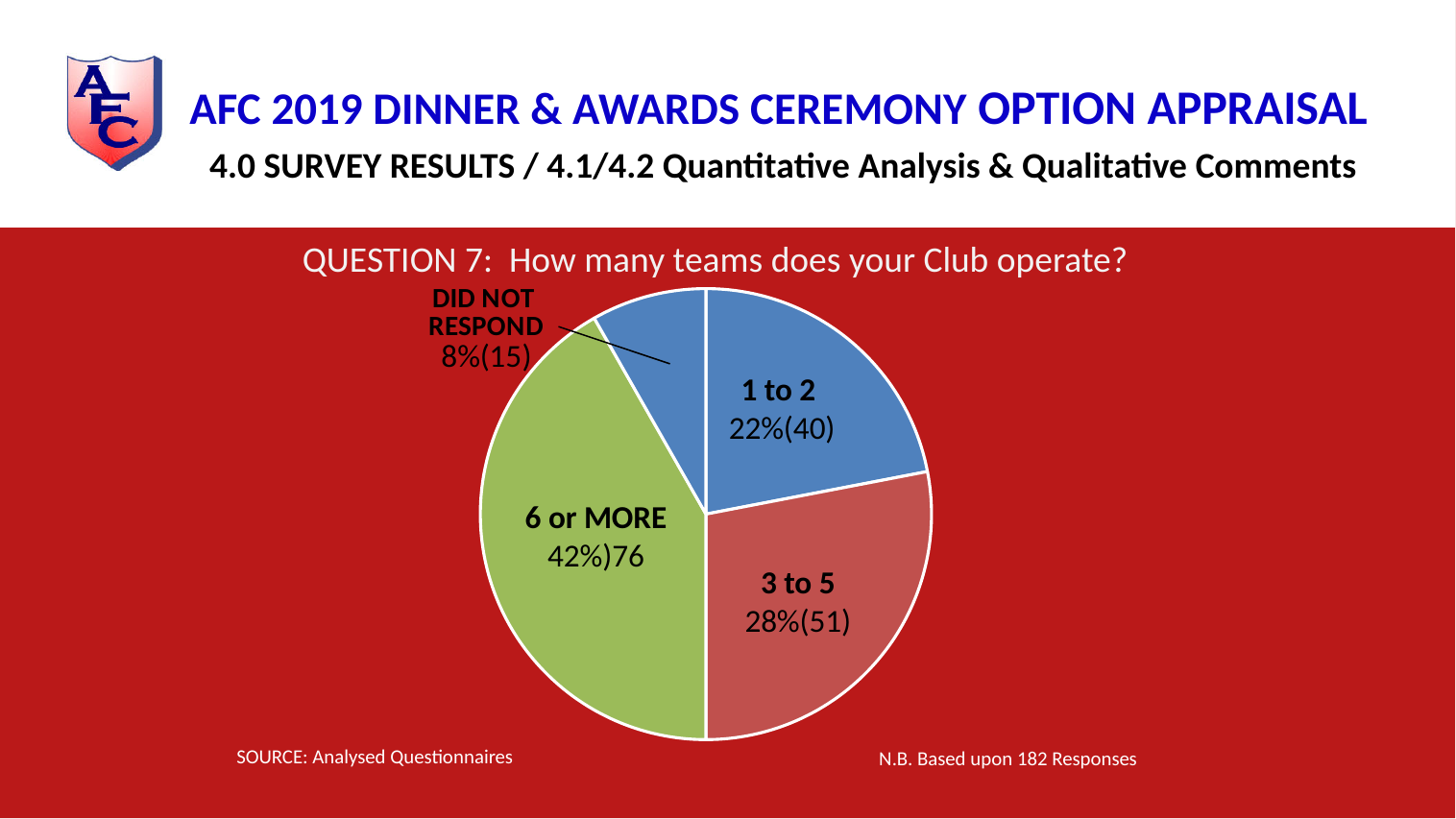
Which category has the smallest share of the pie? DID NOT RESPOND What percentage of respondents did not respond to Question 7? 8% What percentage of clubs operate 3 to 5 teams? 28% Which category has the largest share of the pie? 6 or MORE How many responses are in the '1 to 2' category? 40 What percentage of clubs operate 1 to 2 teams? 22% How many slices does the pie chart have? 4 What is the difference in percentage points between the '6 or MORE' share and the '3 to 5' share? 14 What kind of chart is shown on the slide? pie chart Which is larger: the share for '3 to 5' or the share for '1 to 2'? 3 to 5 How many responses are in the '3 to 5' category? 51